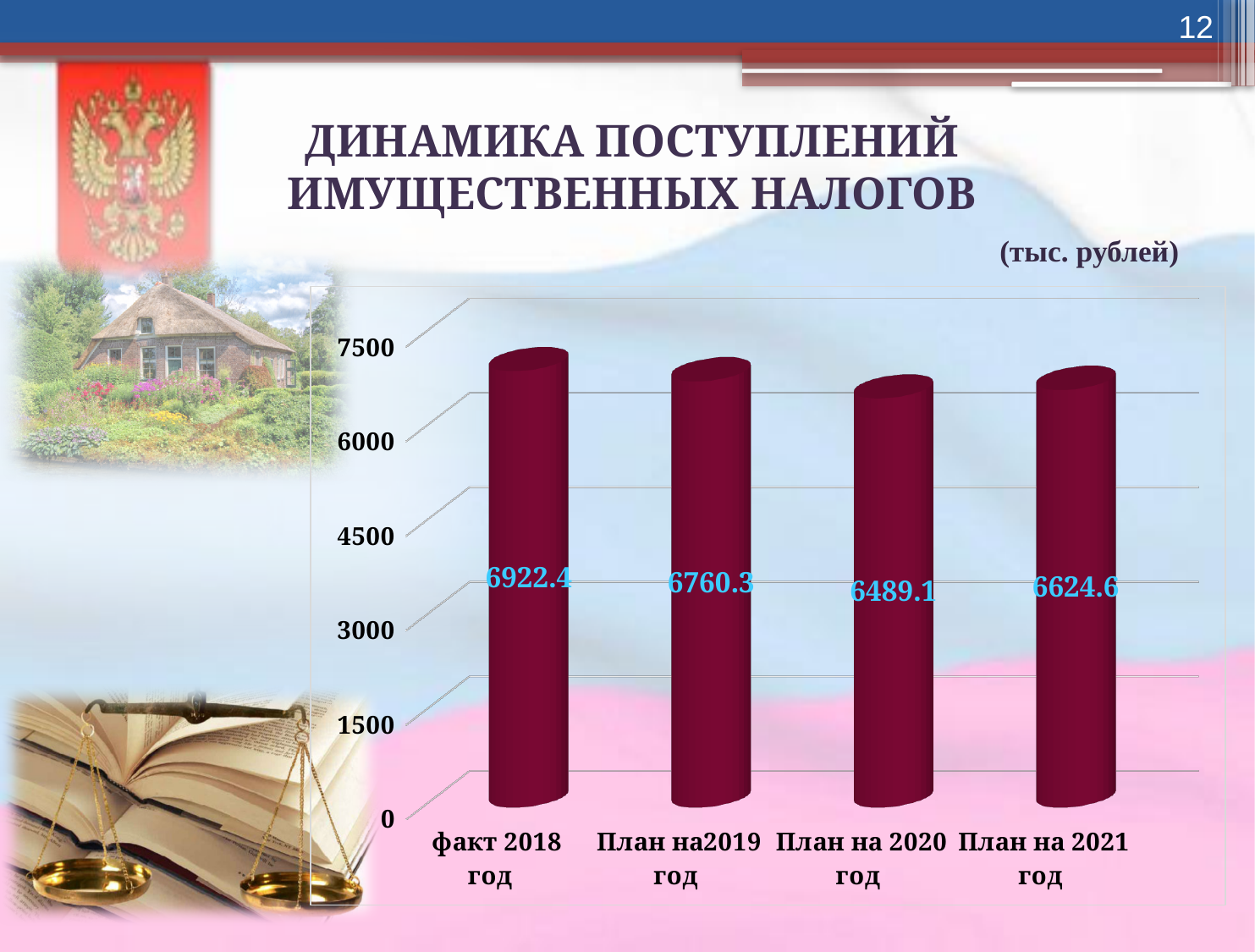
What is the difference between the values for факт 2018 год and План на2019 год? 162.1 Which is larger, the value for План на2019 год or the value for План на 2021 год? План на2019 год What is the difference between the values for План на 2021 год and План на 2020 год? 135.5 Which category has the highest value? факт 2018 год Is the value for План на 2020 год greater or less than 6000? greater What unit is stated for the chart values? тыс. рублей What kind of chart is shown on the slide? bar chart What is the value for факт 2018 год? 6922.4 Which category has the lowest value? План на 2020 год How many categories are shown on the x axis? 4 What is the value for План на 2020 год? 6489.1 What is the value for План на 2021 год? 6624.6